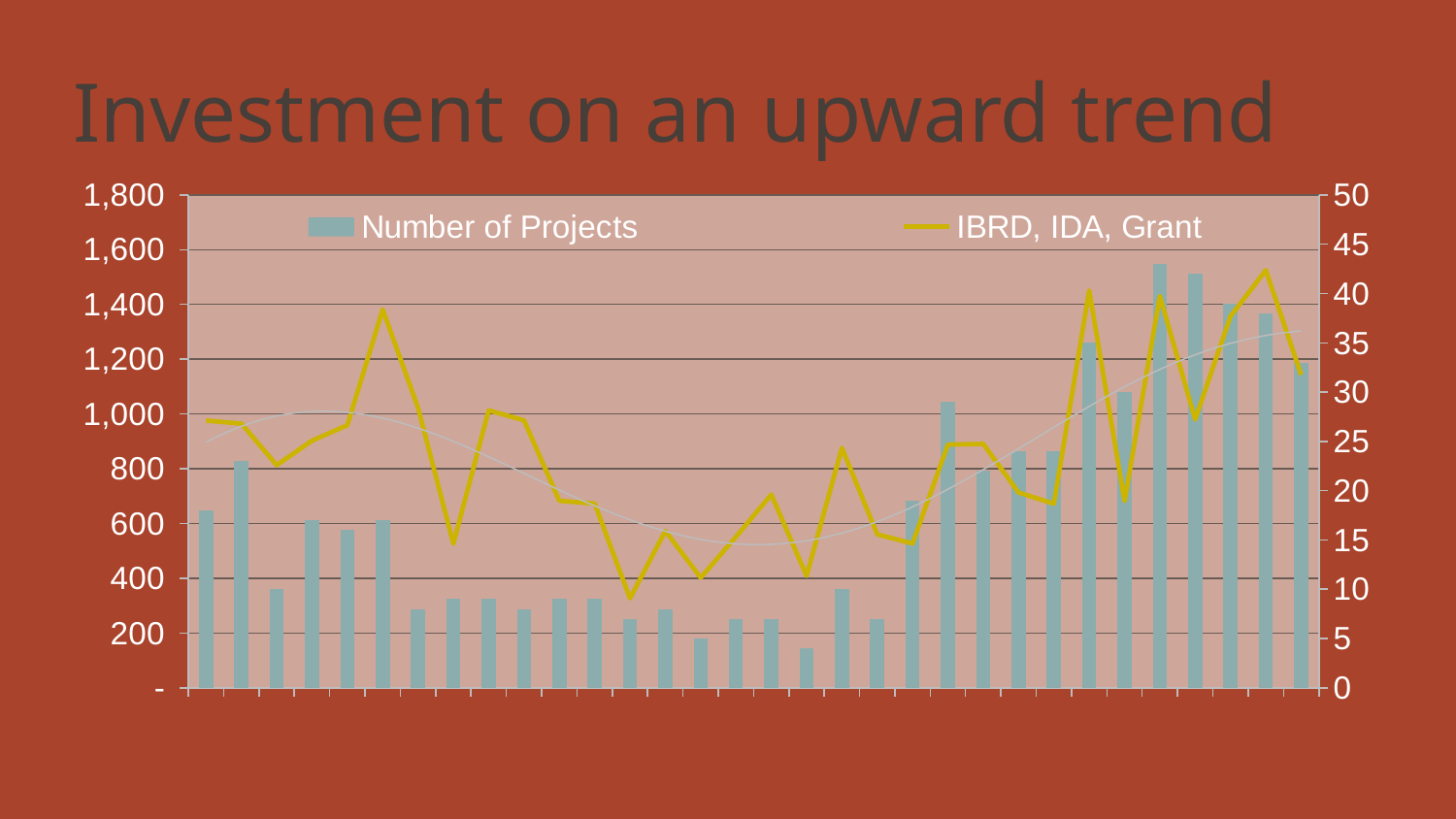
How many series does the chart legend list? 2 What is the title of the slide containing the chart? Investment on an upward trend What are the two series named in the chart legend? Number of Projects; IBRD, IDA, Grant Do the Number of Projects bars generally rise or fall moving from left to right across the chart? Rise Is the first Number of Projects bar on the left taller or shorter than the last bar on the right? Shorter What kind of chart is shown on the slide? A combined bar and line chart